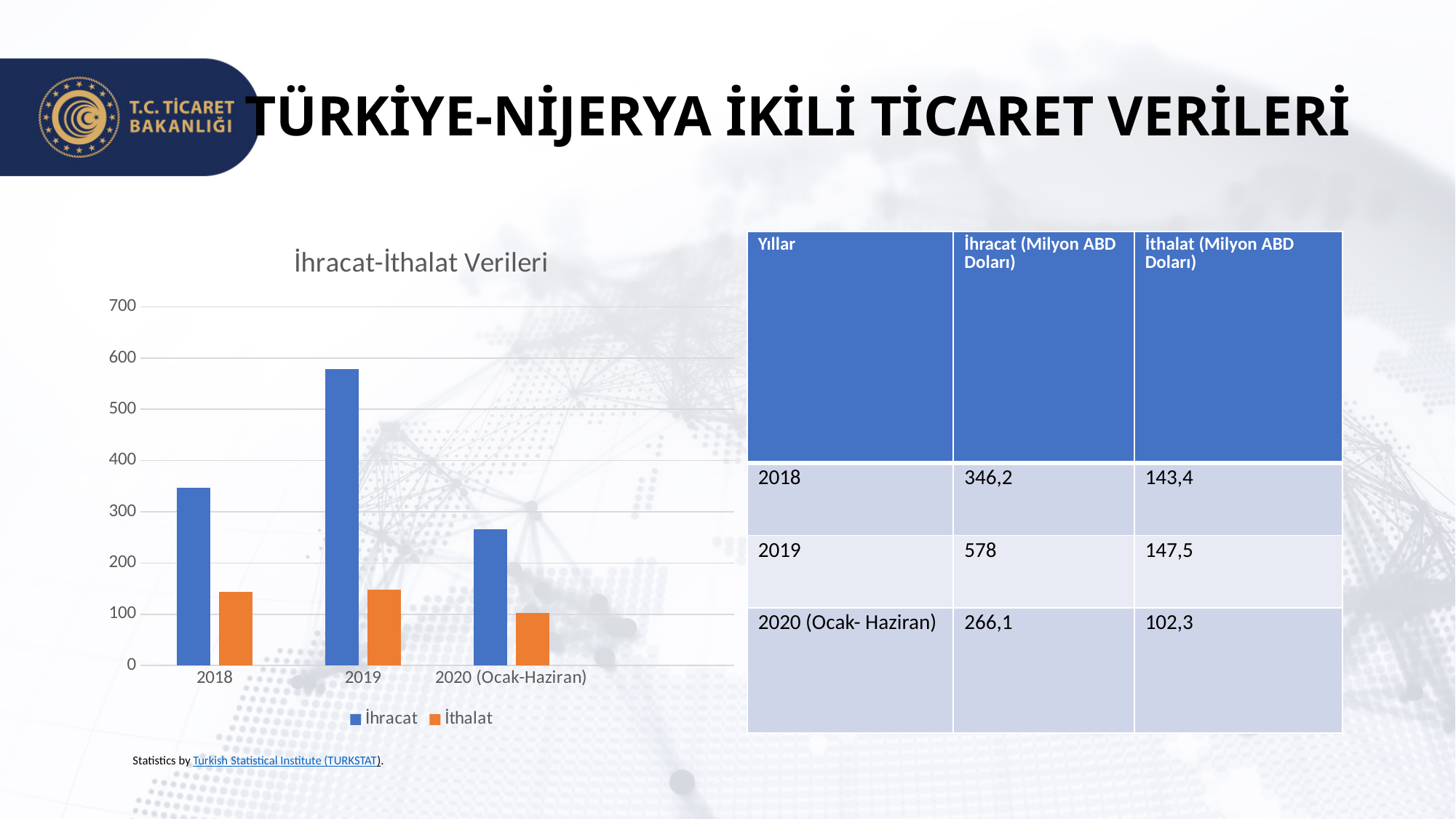
What is the title of the chart? İhracat-İthalat Verileri Is the İhracat bar for 2019 greater or less than 500? greater Is the İthalat bar for 2018 greater or less than 200? less Using the table values, what is the difference between İhracat and İthalat in 2018? 202,8 How many year categories are shown on the x axis of the chart? 3 According to the table on the slide, what is the İthalat value for 2020 (Ocak- Haziran)? 102,3 How many series does the chart legend list? 2 What kind of chart is shown on the slide? bar chart According to the table on the slide, what is the İhracat value for 2019 (Milyon ABD Doları)? 578 Which is larger in 2018, the İhracat bar or the İthalat bar? İhracat Which category has the lowest İthalat bar? 2020 (Ocak-Haziran) Which year has the highest İhracat bar? 2019